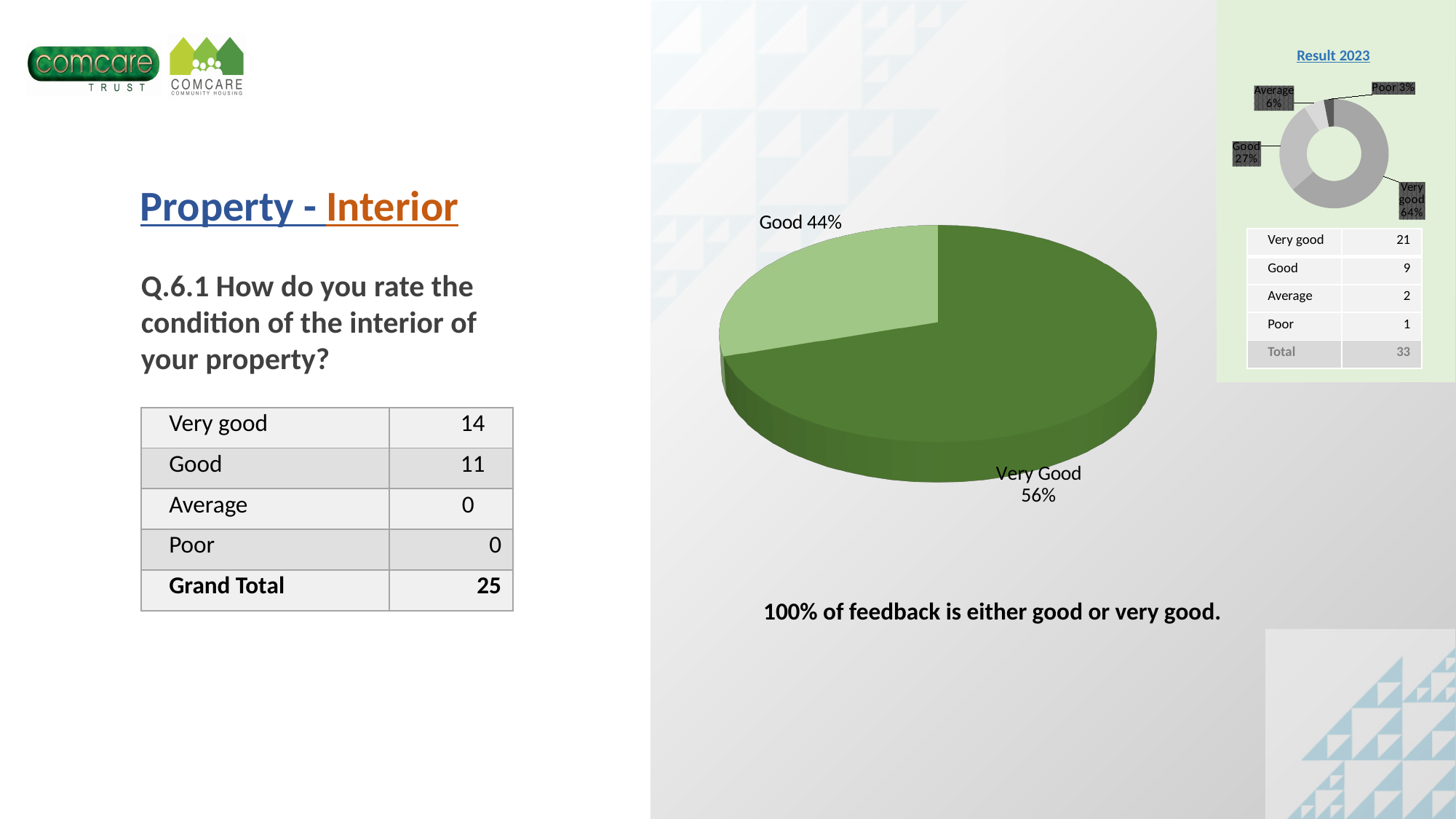
In the large pie chart in the centre of the slide, which category has the smallest slice? Good In the large pie chart in the centre of the slide, which category has the largest slice? Very Good In the large pie chart in the centre of the slide, what is the difference in percentage points between the Very Good and Good slices? 12 percentage points In the 'Result 2023' chart at the top right, what share is labelled for Good? 27% In the large pie chart in the centre of the slide, what share is labelled for Good? 44% In the large pie chart in the centre of the slide, how many slices are shown? 2 In the 'Result 2023' chart at the top right, how many categories are shown? 4 In the large pie chart in the centre of the slide, what share is labelled for Very Good? 56% What kind of chart is the large chart in the centre of the slide? Pie chart In the 'Result 2023' chart at the top right, which category has the smallest slice? Poor In the 'Result 2023' chart at the top right, what share is labelled for Very good? 64% In the 'Result 2023' chart at the top right, what share is labelled for Poor? 3%